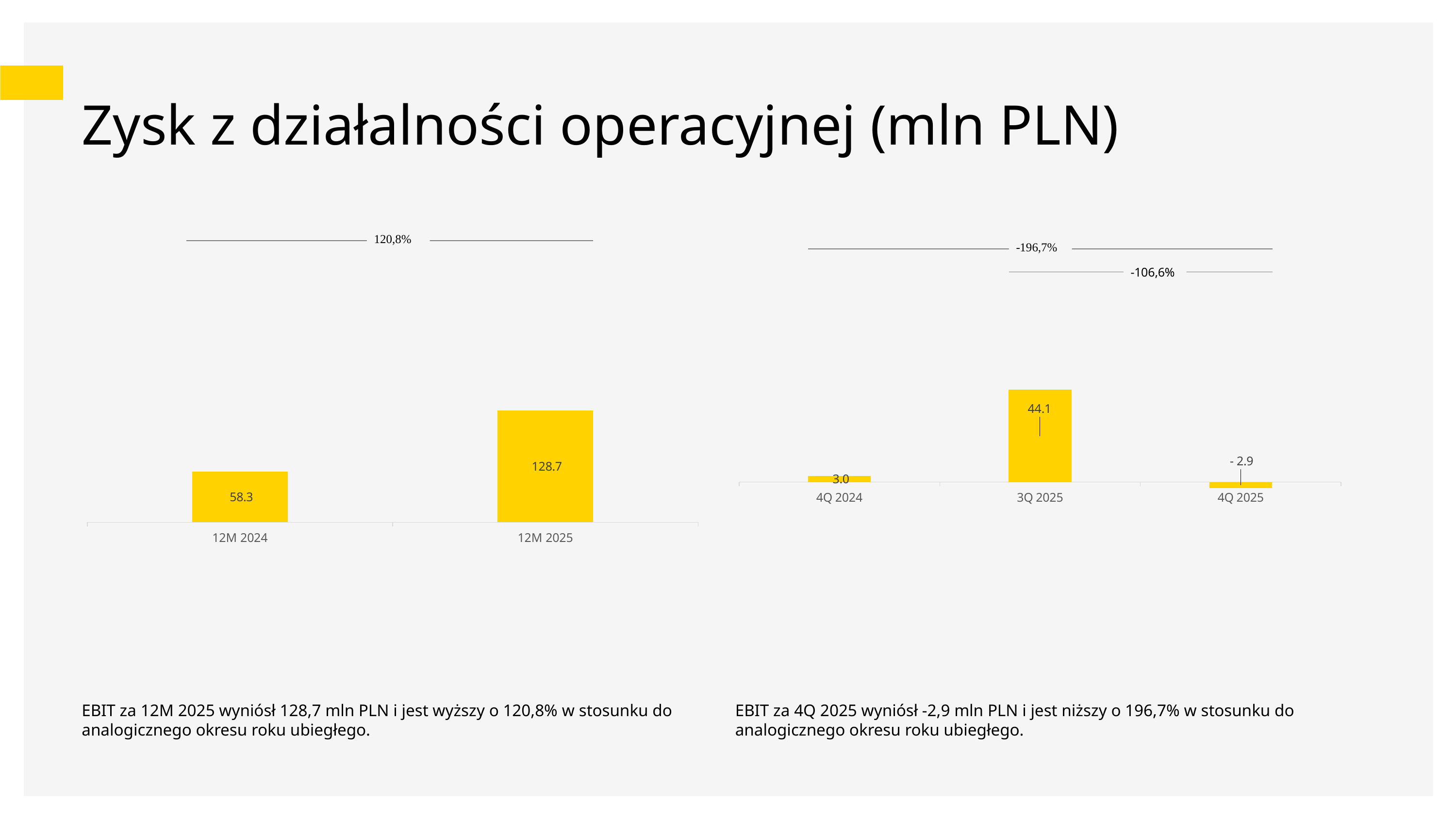
In the left chart, what is the difference between the 12M 2025 and 12M 2024 values? 70.4 In the left chart, how many categories are shown on the x axis? 2 In the left chart, what is the value for 12M 2025? 128.7 In the right chart, which category has the lowest value? 4Q 2025 In the right chart, what is the value for 4Q 2024? 3.0 In the left chart, what percentage change is shown between 12M 2024 and 12M 2025? 120,8% In the right chart, what is the value for 3Q 2025? 44.1 In the right chart, what percentage change is shown between 4Q 2024 and 4Q 2025? -196,7% In the right chart, what is the value for 4Q 2025? -2.9 In the left chart, what is the value for 12M 2024? 58.3 What kind of chart is the right chart? bar chart In the right chart, which category has the highest value? 3Q 2025